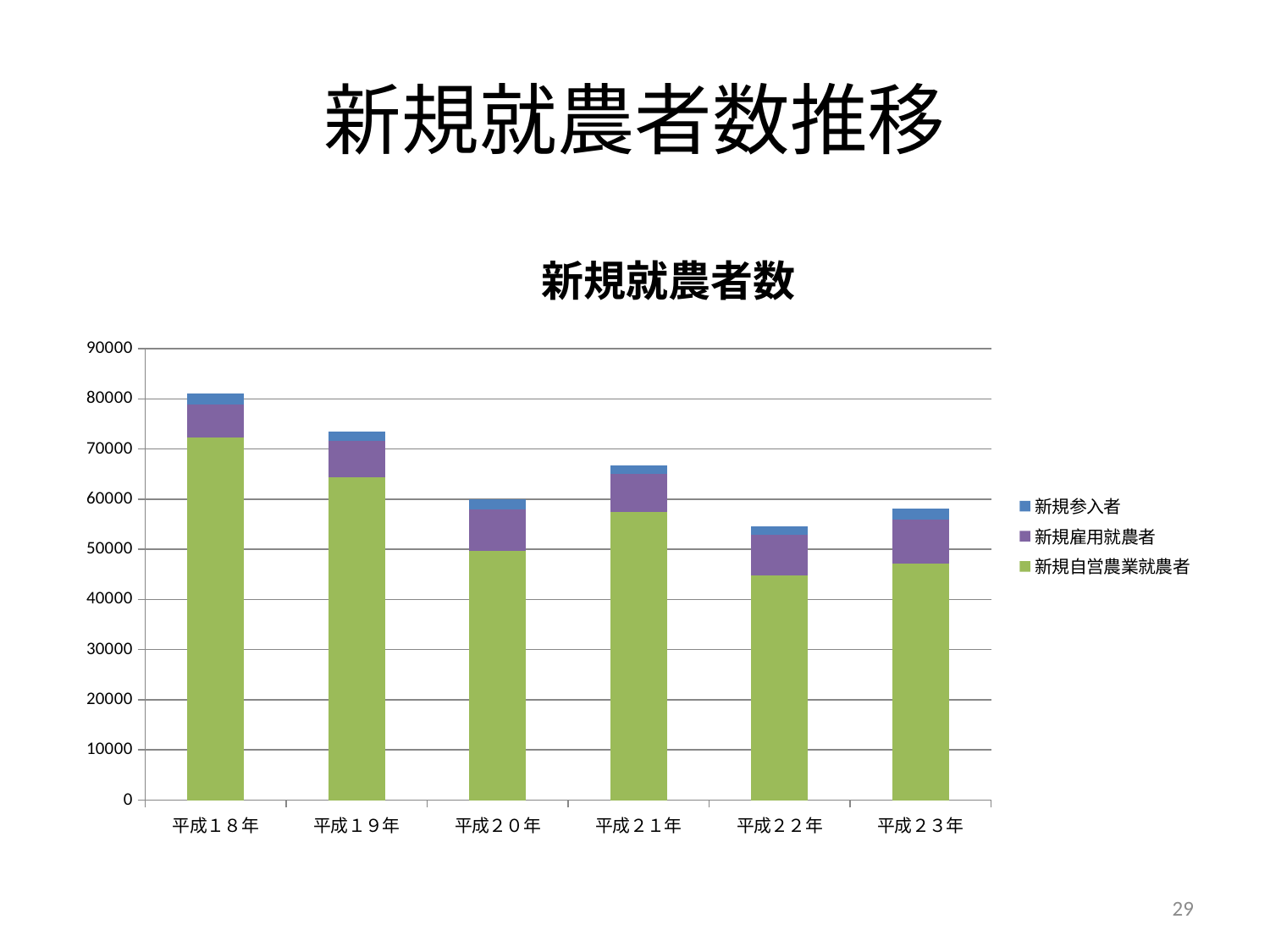
Which year has a larger total stacked bar, 平成１９年 or 平成２０年? 平成１９年 How many years (categories) are shown on the x axis of the chart? 6 Which year has the lowest total stacked bar? 平成２２年 Is the total stacked bar for 平成２２年 greater or less than 60000? less Which year has the highest total stacked bar? 平成１８年 Is the 新規自営農業就農者 value for 平成２１年 greater or less than 50000? greater Is the total stacked bar for 平成１８年 greater or less than 70000? greater What kind of chart is shown on the slide? Stacked bar chart Do the total stacked bars generally rise or fall from 平成１８年 to 平成２３年? fall Which colour represents 新規自営農業就農者 in the chart? Green What is the title of the chart? 新規就農者数 How many series does the legend of the chart list? 3